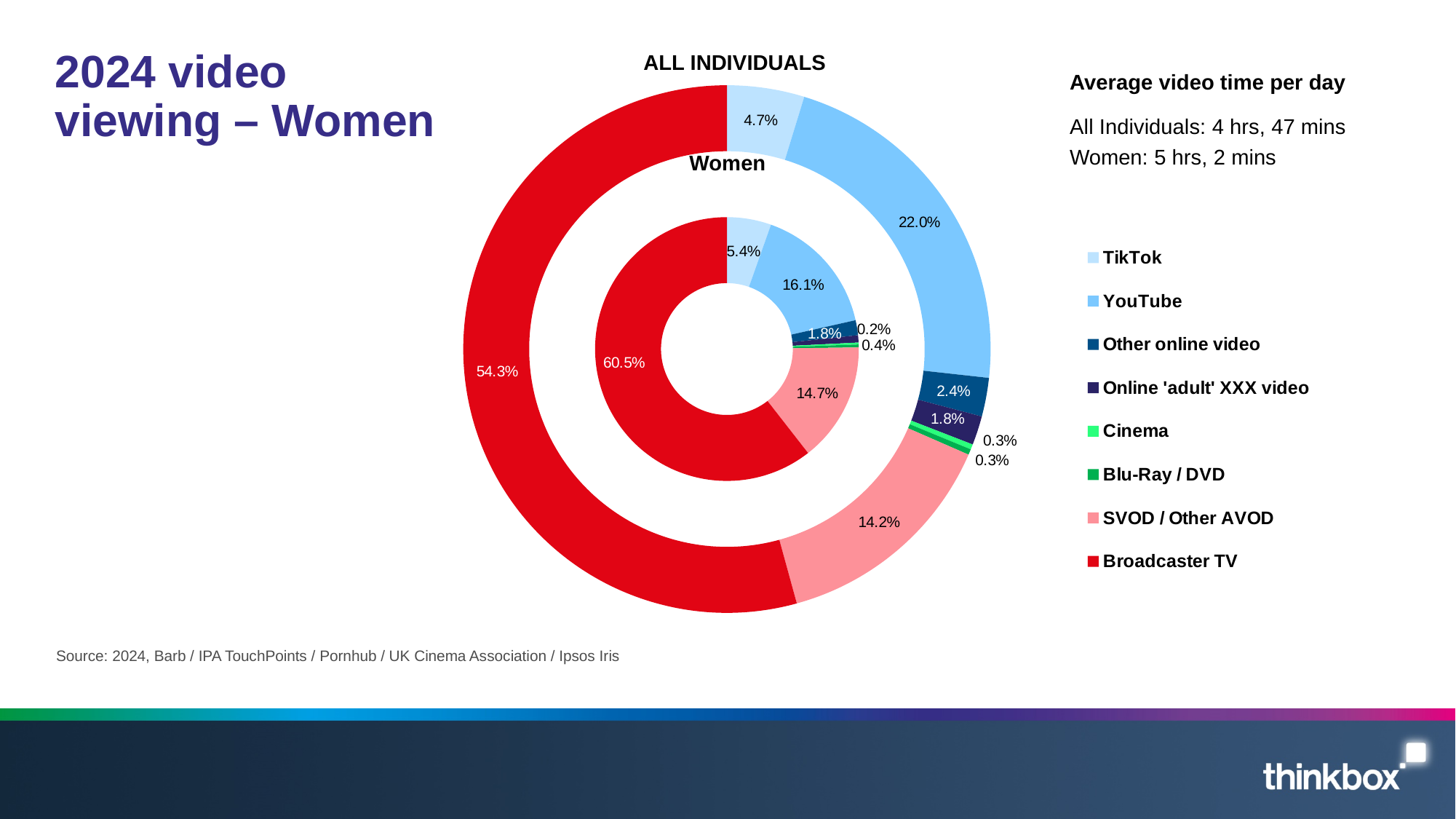
How many categories does the legend list? 8 What kind of chart is shown on the slide? Doughnut chart Which category has the largest share in the Women ring? Broadcaster TV In the ALL INDIVIDUALS ring, what is the value for TikTok? 4.7% In the ALL INDIVIDUALS ring, what share of video viewing is Broadcaster TV? 54.3% In the ALL INDIVIDUALS ring, what is the value for YouTube? 22.0% Is the TikTok share larger for Women or for All Individuals? Women In the Women ring, what is the value for YouTube? 16.1% What is the difference between the Broadcaster TV share for Women and for All Individuals? 6.2% In the Women ring, what share of video viewing is Broadcaster TV? 60.5% According to the slide, what is the average video time per day for Women? 5 hrs, 2 mins In the Women ring, what is the value for SVOD / Other AVOD? 14.7%